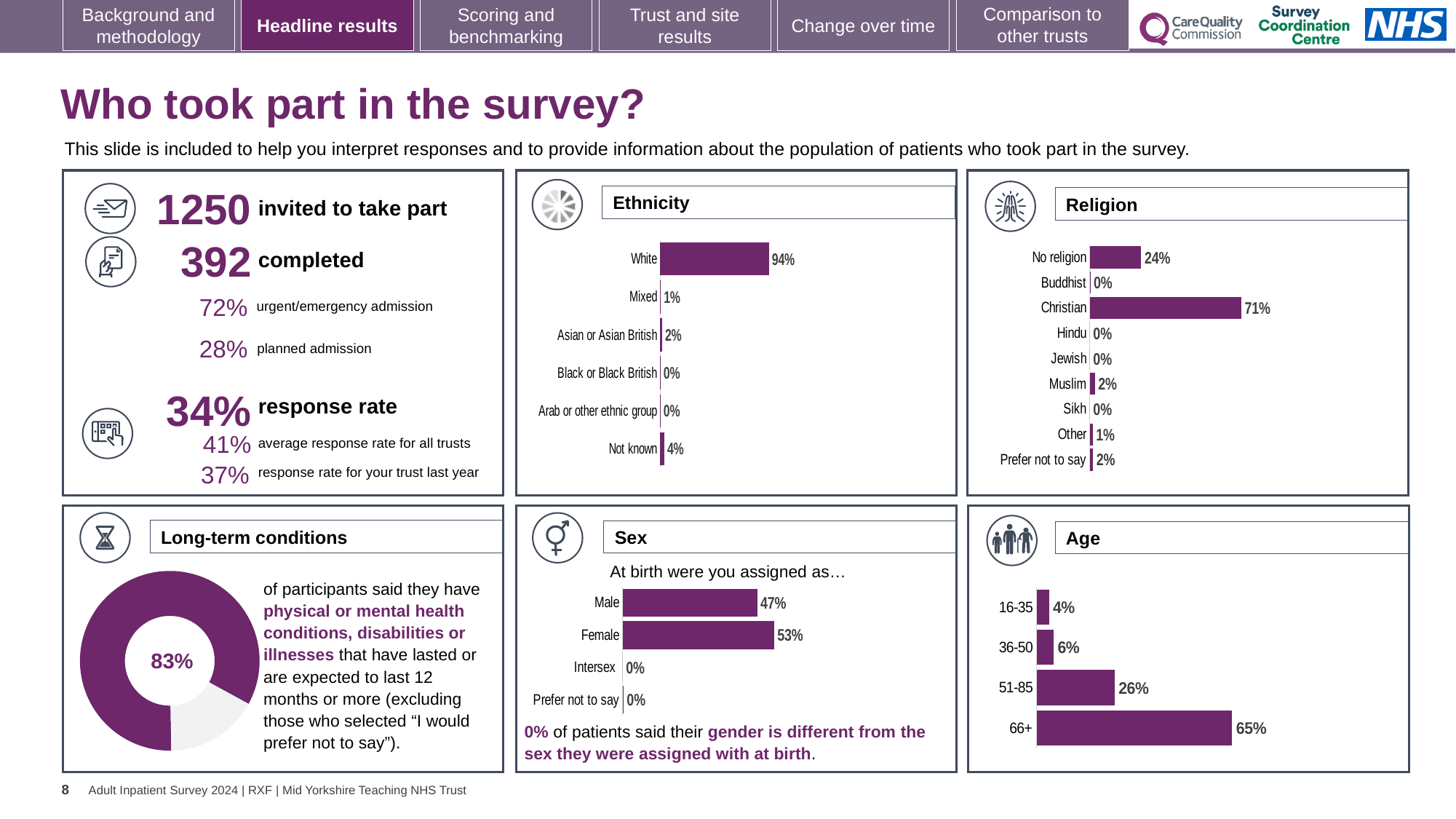
What kind of chart is used in the Long-term conditions panel? doughnut chart In the Religion chart, what percentage of participants were Christian? 71% In the Age chart, do the values rise or fall as age increases from 16-35 to 66+? rise In the Age chart, what percentage of participants were aged 66+? 65% In the Religion chart, what is the difference between the Christian and No religion values? 47% In the Sex chart, what percentage of participants were Female? 53% In the Ethnicity chart, which category has the highest value? White In the Sex chart, which is larger, Male or Female? Female In the Age chart, what is the difference between the 51-85 and 36-50 values? 20% In the Ethnicity chart, how many categories are shown? 6 In the Religion chart, how many categories are shown? 9 In the Ethnicity chart, what percentage of participants were White? 94%